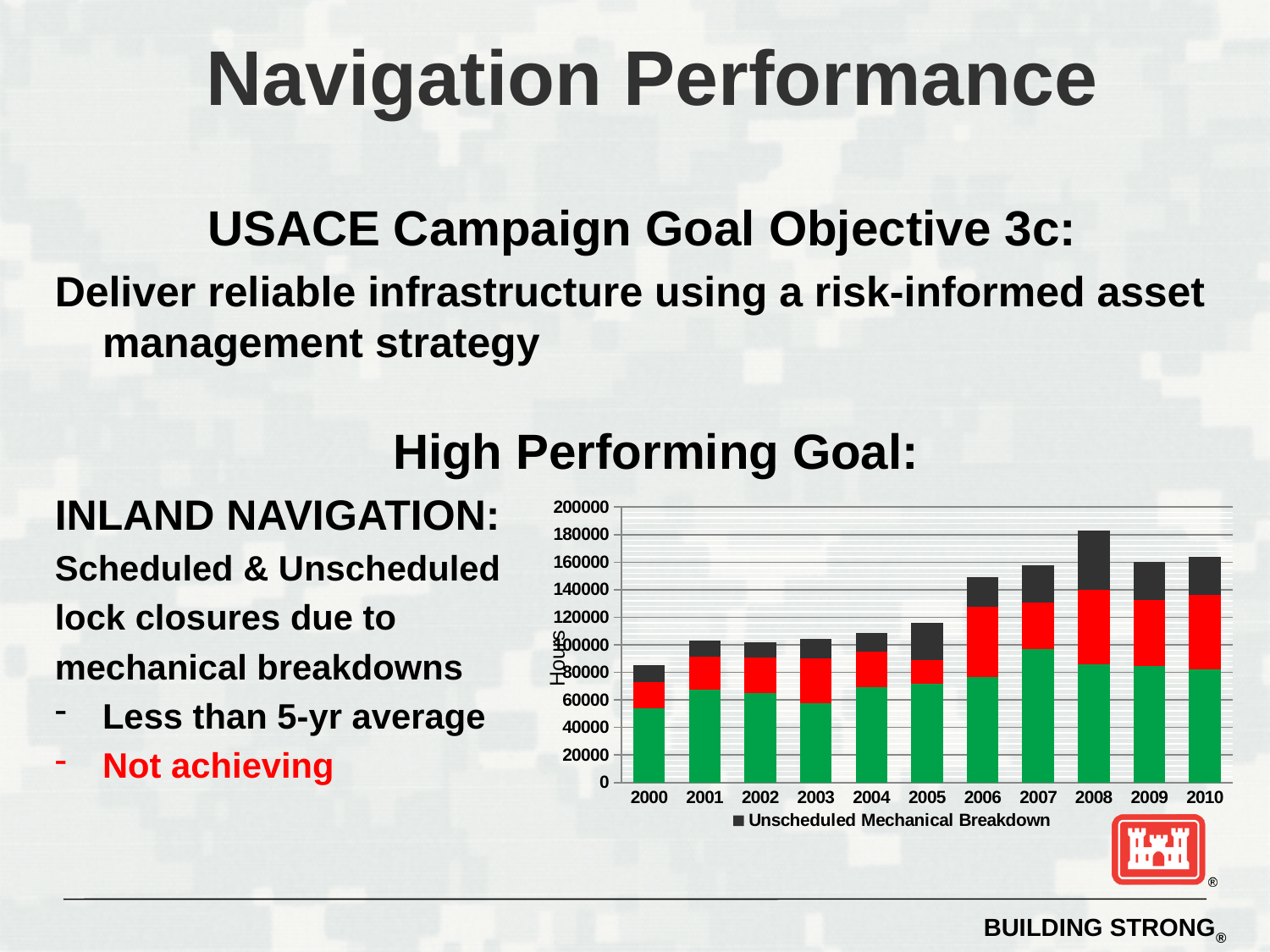
Is the total bar height for 2005 greater or less than 120000? less Which series name is shown in the chart's legend? Unscheduled Mechanical Breakdown Is the total bar height for 2000 greater or less than 100000? less How many years are shown on the x axis of the chart? 11 Is the total bar height for 2006 greater or less than 140000? greater Do the total bar heights generally rise or fall from 2000 to 2010? rise What is the label on the vertical axis of the chart? Hours Which year has the tallest stacked bar in the chart? 2008 Which year has the shortest stacked bar in the chart? 2000 Which year has a taller stacked bar, 2006 or 2005? 2006 What kind of chart is shown on the slide? stacked bar chart